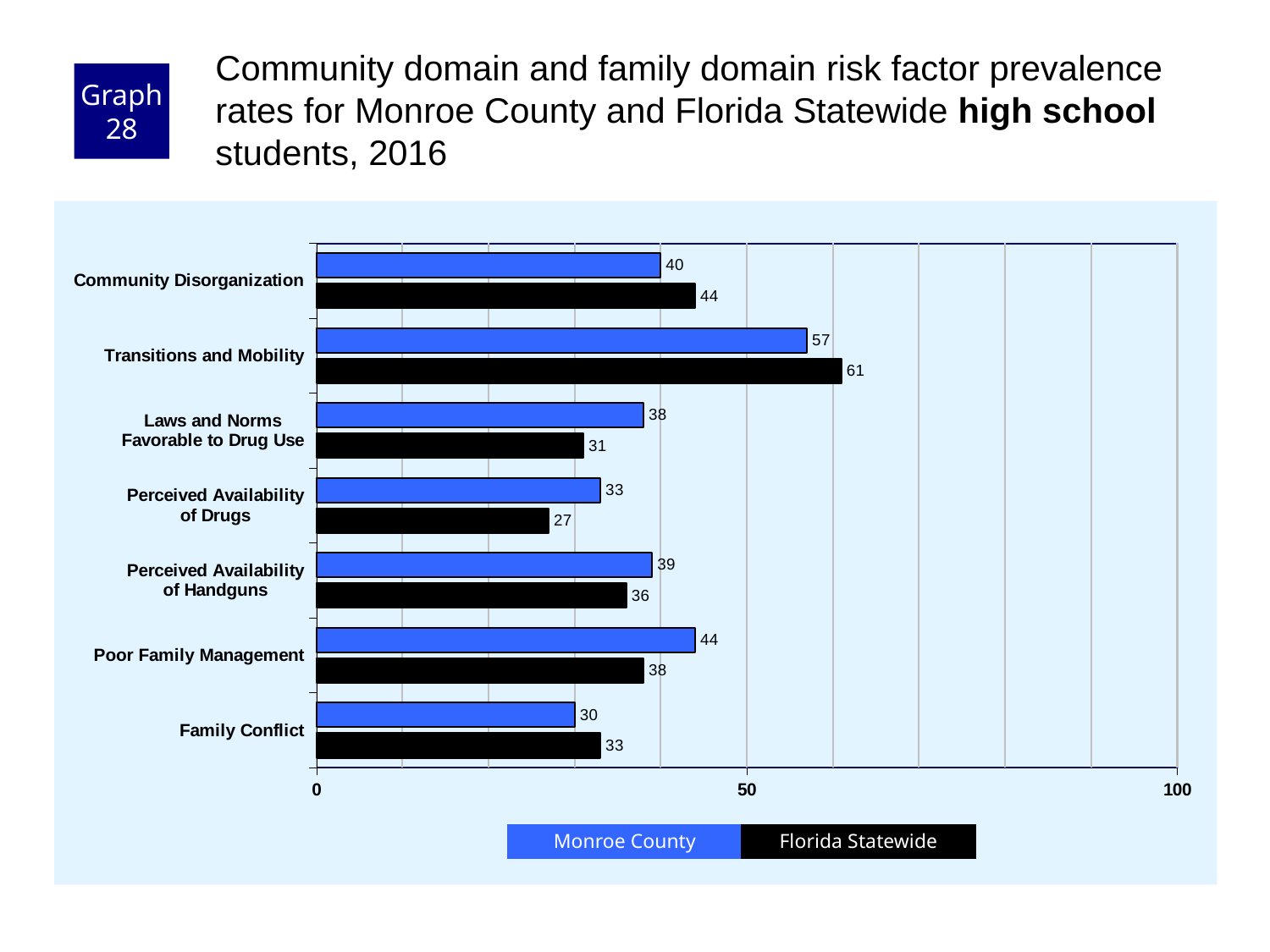
How many series does the legend list? 2 Is the Florida Statewide value for Transitions and Mobility greater or less than 50? greater How many risk factor categories are shown on the chart? 7 For Poor Family Management, which is larger: the Monroe County value or the Florida Statewide value? Monroe County What is the difference between the Monroe County and Florida Statewide values for Laws and Norms Favorable to Drug Use? 7 What kind of chart is shown on the slide? Bar chart What is the Florida Statewide value for Community Disorganization? 44 Which risk factor has the highest Florida Statewide value? Transitions and Mobility Which risk factor has the lowest Monroe County value? Family Conflict What is the Monroe County value for Transitions and Mobility? 57 What is the difference between the Florida Statewide and Monroe County values for Transitions and Mobility? 4 What is the Florida Statewide value for Perceived Availability of Drugs? 27